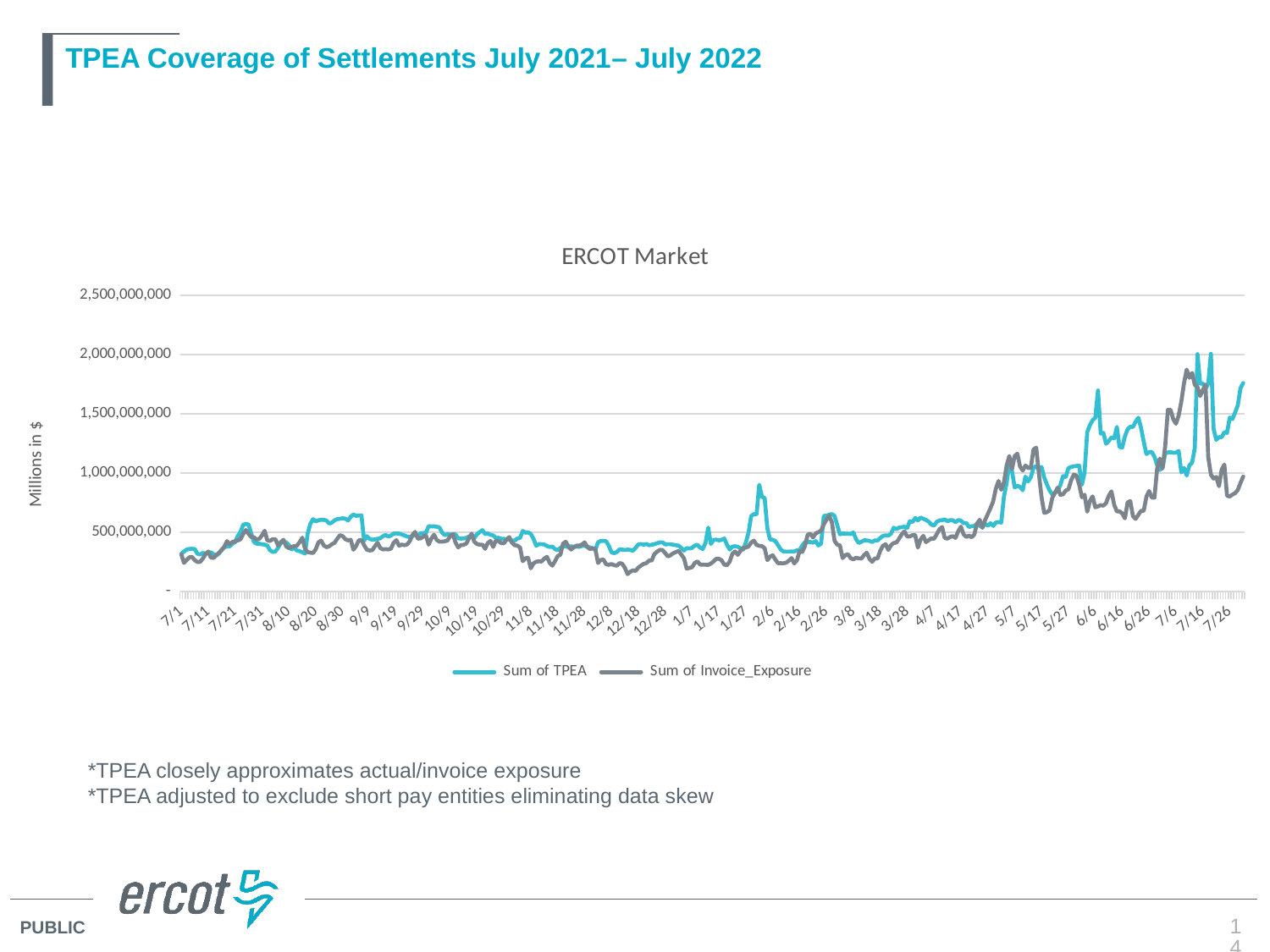
Which series reaches the highest value on the chart? Sum of TPEA How many series does the legend list? 2 What kind of chart is shown on the slide? Line chart What are the two series named in the legend? Sum of TPEA and Sum of Invoice_Exposure Is the value for Sum of Invoice_Exposure around 12/18 greater or less than 500,000,000? less Is the value for Sum of TPEA around 6/6 greater or less than 1,000,000,000? greater Is the highest value reached by Sum of TPEA greater or less than 1,500,000,000? greater Around 6/6, which series has the larger value, Sum of TPEA or Sum of Invoice_Exposure? Sum of TPEA What is the title of the chart? ERCOT Market Do the values for Sum of TPEA generally rise or fall from 7/1 to 7/26 along the x axis? Rise